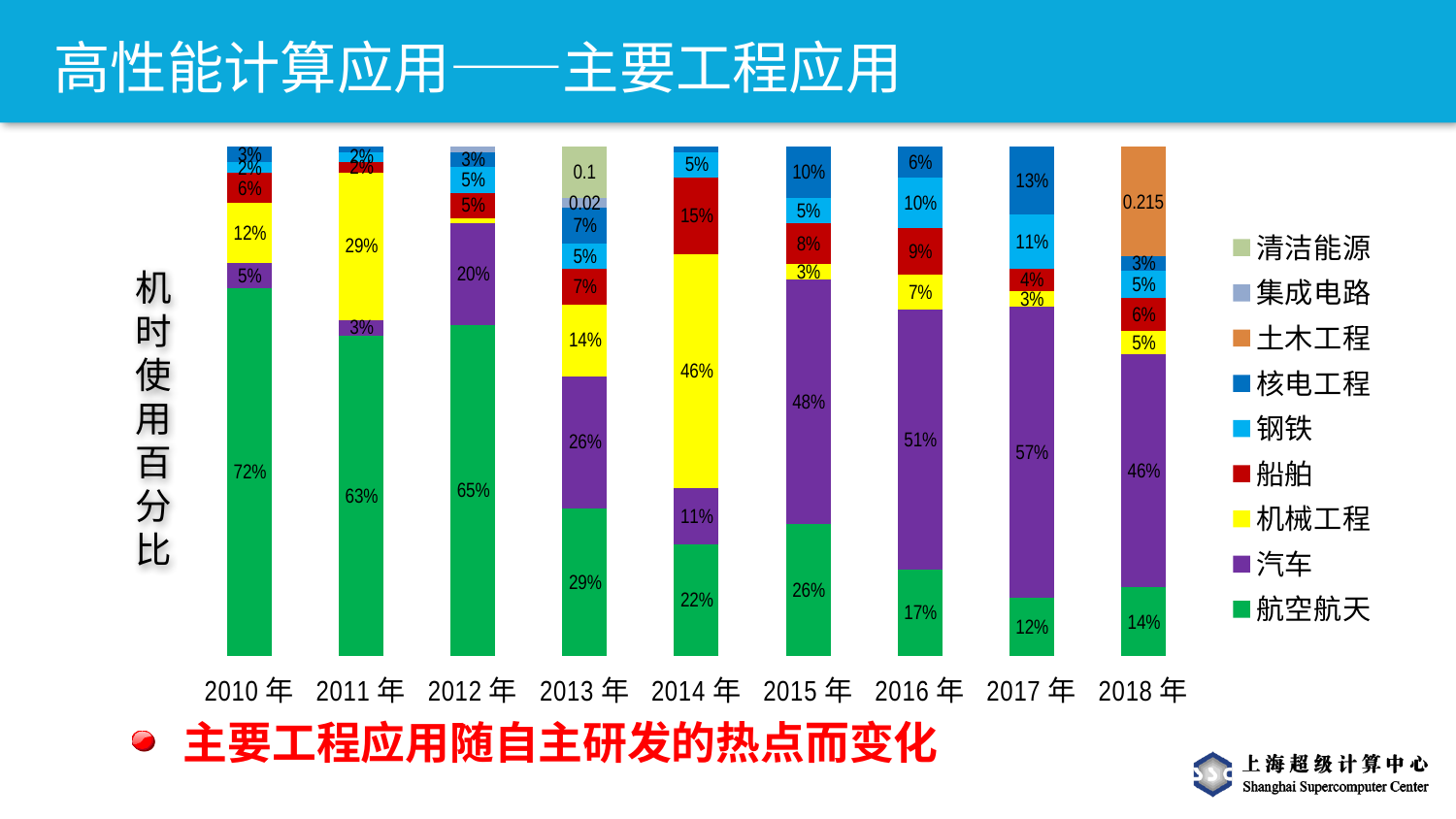
In which year is the 航空航天 share the highest? 2010 年 What is the value for 汽车 in 2017 年? 57% What is the value for 土木工程 in 2018 年? 0.215 What is the value for 机械工程 in 2014 年? 46% What is the difference between the 汽车 value in 2016 年 and the 汽车 value in 2014 年? 40% Which is larger in 2013 年, the value for 航空航天 or the value for 汽车? 航空航天 In which year is the 航空航天 share the lowest? 2017 年 How many series does the legend list? 9 How many years are shown on the x axis? 9 What is the value for 航空航天 in 2010 年? 72% Does the 航空航天 share generally rise or fall from 2010 年 to 2018 年? Fall What kind of chart is shown on the slide? Stacked bar chart